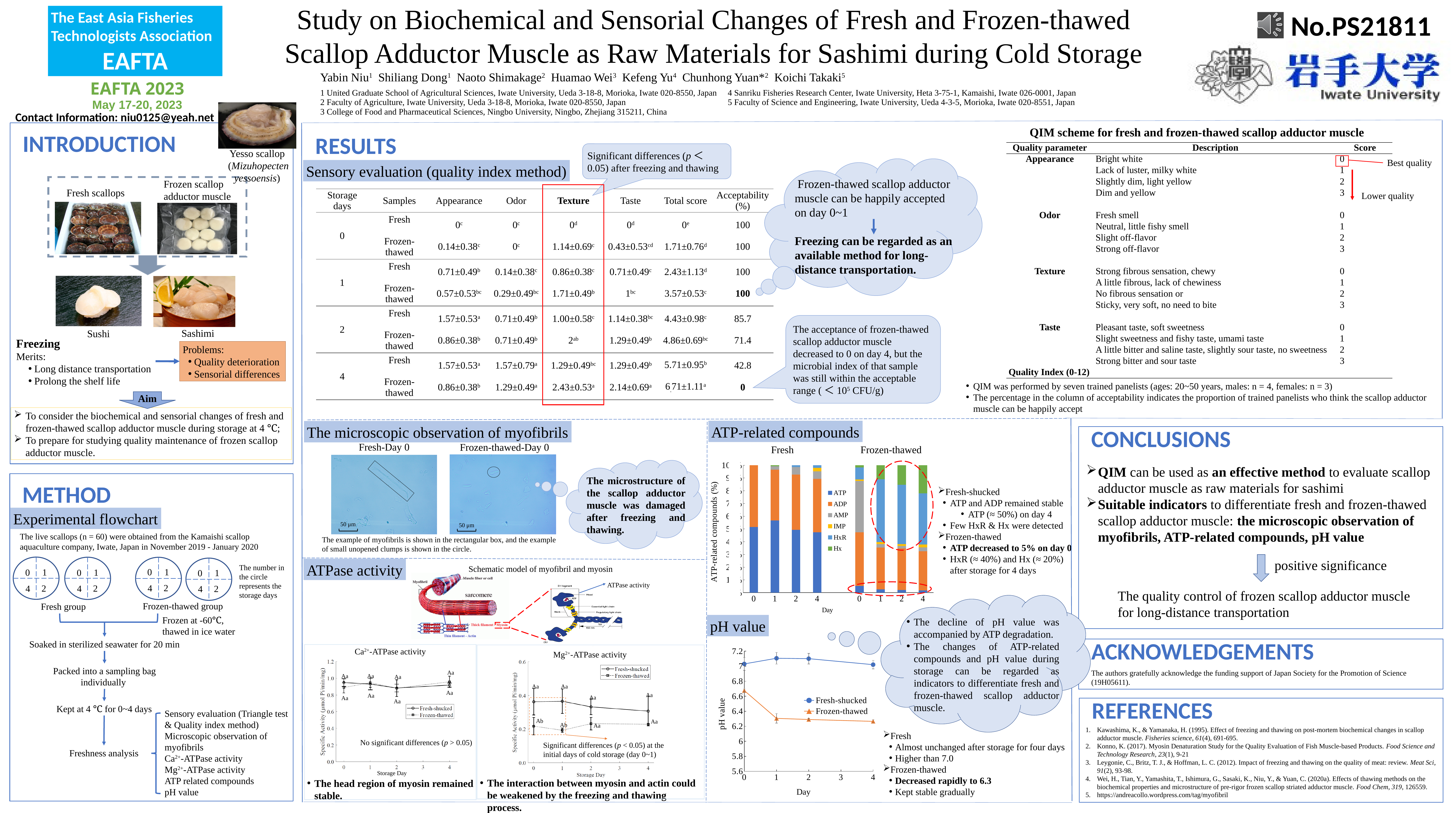
In the pH value chart, is the Fresh-shucked value on day 4 greater or less than 6.8? greater How many series does the legend of the pH value chart list? 2 In the Mg2+-ATPase activity chart, which series has the higher value on day 0, Fresh-shucked or Frozen-thawed? Fresh-shucked What kind of chart is the pH value chart? line chart How many bars are plotted in the ATP-related compounds chart? 8 In the pH value chart, which series has the higher value on day 4, Fresh-shucked or Frozen-thawed? Fresh-shucked In the pH value chart, is the Frozen-thawed value on day 4 greater or less than 6.6? less Which compounds are listed in the legend of the ATP-related compounds chart? ATP, ADP, AMP, IMP, HxR, Hx In the ATP-related compounds chart, is the ATP share for Fresh on day 4 greater or less than 20%? greater How many series does the legend of the ATP-related compounds chart list? 6 What kind of chart is the ATP-related compounds chart? stacked bar chart In the pH value chart, does the Frozen-thawed series rise or fall from day 0 to day 4? fall